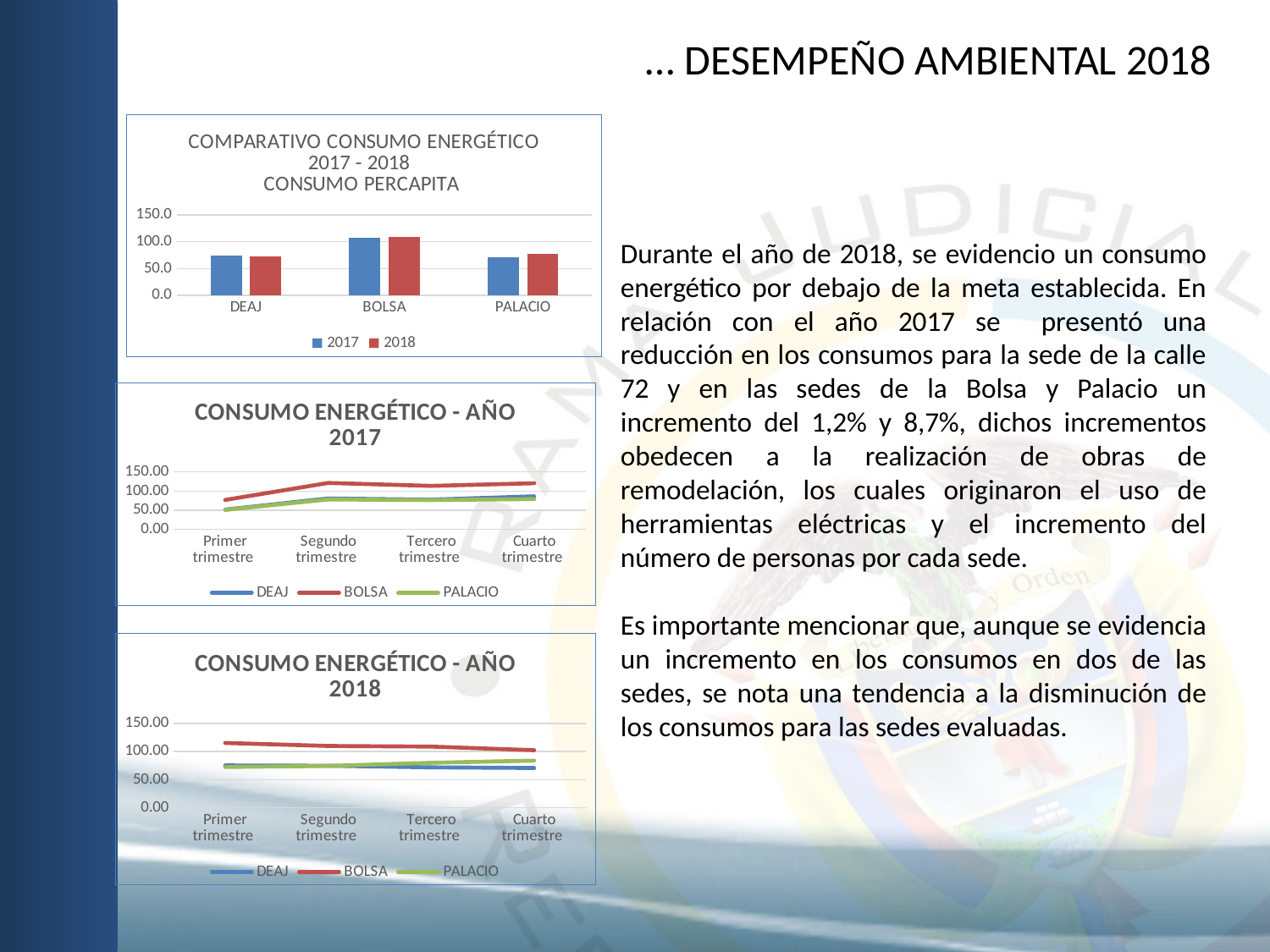
In the chart titled 'COMPARATIVO CONSUMO ENERGÉTICO 2017 - 2018 CONSUMO PERCAPITA', is the 2018 value for BOLSA greater or less than 100.0? greater In the chart titled 'COMPARATIVO CONSUMO ENERGÉTICO 2017 - 2018 CONSUMO PERCAPITA', how many series does the legend list? 2 In the chart titled 'CONSUMO ENERGÉTICO - AÑO 2017', what kind of chart is it? line chart In the chart titled 'CONSUMO ENERGÉTICO - AÑO 2017', is the BOLSA value for Segundo trimestre greater or less than 100.00? greater In the chart titled 'COMPARATIVO CONSUMO ENERGÉTICO 2017 - 2018 CONSUMO PERCAPITA', what kind of chart is it? bar chart In the chart titled 'COMPARATIVO CONSUMO ENERGÉTICO 2017 - 2018 CONSUMO PERCAPITA', which category has the highest values? BOLSA In the chart titled 'CONSUMO ENERGÉTICO - AÑO 2018', how many quarters are shown on the x axis? 4 In the chart titled 'COMPARATIVO CONSUMO ENERGÉTICO 2017 - 2018 CONSUMO PERCAPITA', is the 2018 value for PALACIO greater or less than 100.0? less In the chart titled 'COMPARATIVO CONSUMO ENERGÉTICO 2017 - 2018 CONSUMO PERCAPITA', how many categories are shown on the x axis? 3 In the chart titled 'CONSUMO ENERGÉTICO - AÑO 2017', how many series does the legend list? 3 In the chart titled 'CONSUMO ENERGÉTICO - AÑO 2018', does the BOLSA line rise or fall from Primer trimestre to Cuarto trimestre? fall In the chart titled 'CONSUMO ENERGÉTICO - AÑO 2017', which series has the highest values across the quarters? BOLSA